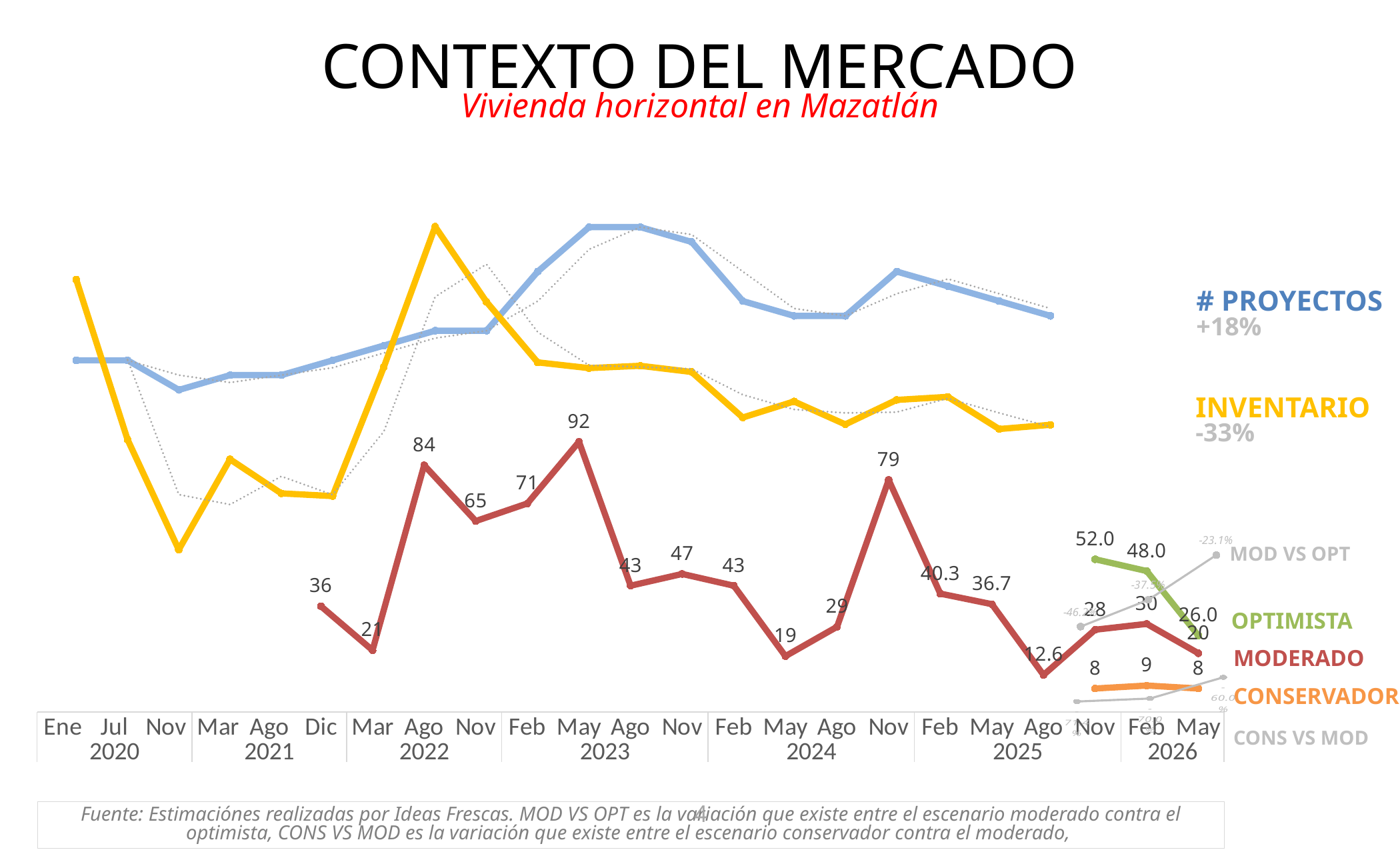
What type of chart is shown on the slide? line chart What is the difference between the OPTIMISTA value (48.0) and the MODERADO value (30) at Feb 2026? 18.0 What is the value of the CONSERVADOR line at Feb 2026? 9 What is the value of the OPTIMISTA line at Nov 2025? 52.0 What is the difference between the MODERADO values at May 2023 (92) and Ago 2023 (43)? 49 What is the value of the MODERADO line at Nov 2024? 79 Does the OPTIMISTA line rise or fall from Nov 2025 to May 2026? fall What percentage change is shown next to the INVENTARIO label? -33% What is the highest labelled value on the MODERADO line? 92 What is the lowest labelled value on the MODERADO line? 12.6 Which is larger at May 2026: the OPTIMISTA value or the MODERADO value? OPTIMISTA What percentage change is shown next to the # PROYECTOS label? +18%